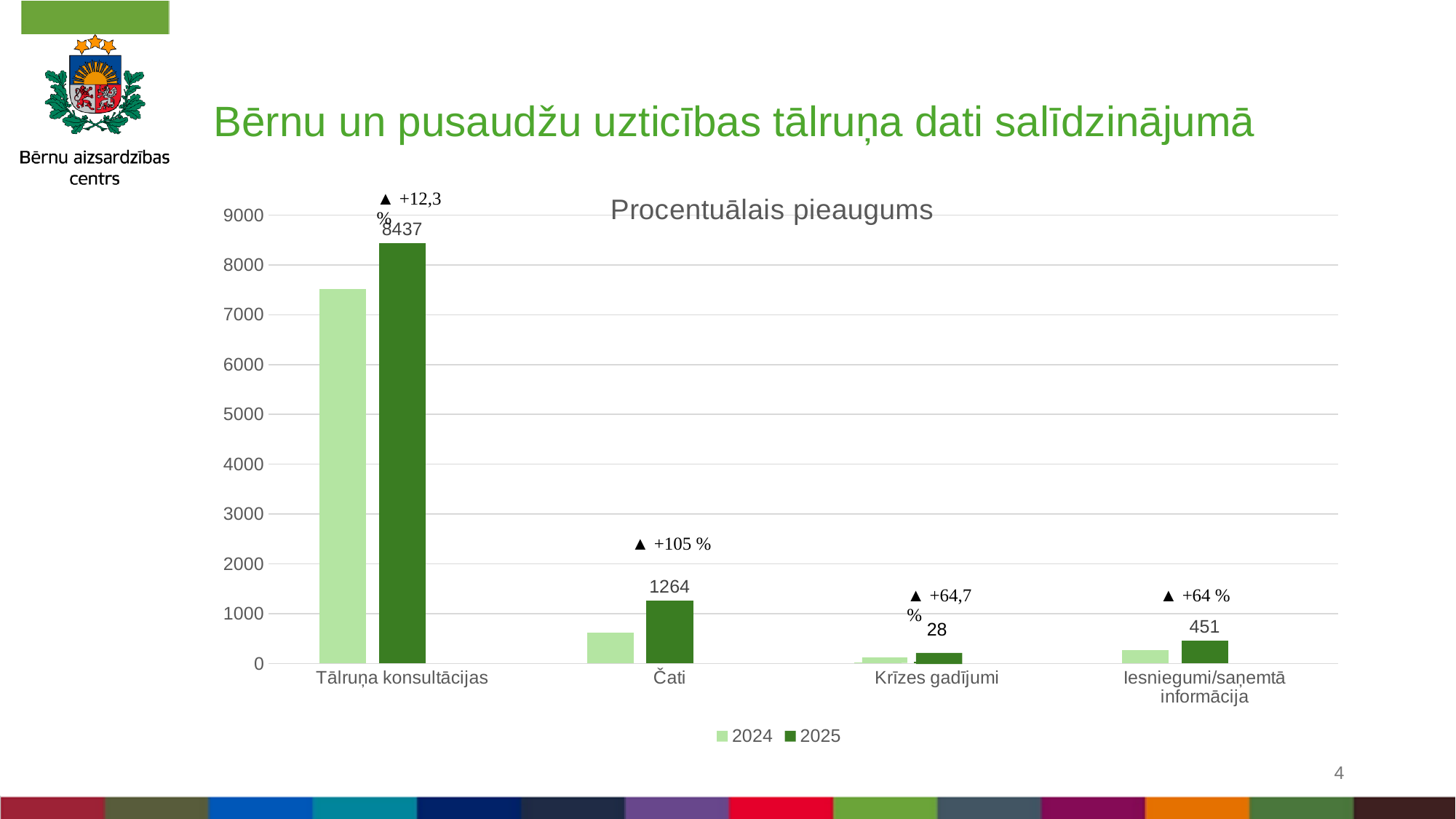
What type of chart is shown on the slide? bar chart What is the 2025 value for Iesniegumi/saņemtā informācija? 451 Which category has the lowest 2025 value? Krīzes gadījumi What percentage increase is shown above the Tālruņa konsultācijas bars? +12,3 % How many categories are shown on the x axis? 4 Which category has the highest 2025 value? Tālruņa konsultācijas How many series does the legend list? 2 What is the 2025 value for Tālruņa konsultācijas? 8437 Is the 2024 value for Tālruņa konsultācijas greater or less than 7000? greater Is the 2024 value for Čati greater or less than 1000? less What percentage increase is shown above the Čati bars? +105 % What is the 2025 value for Čati? 1264